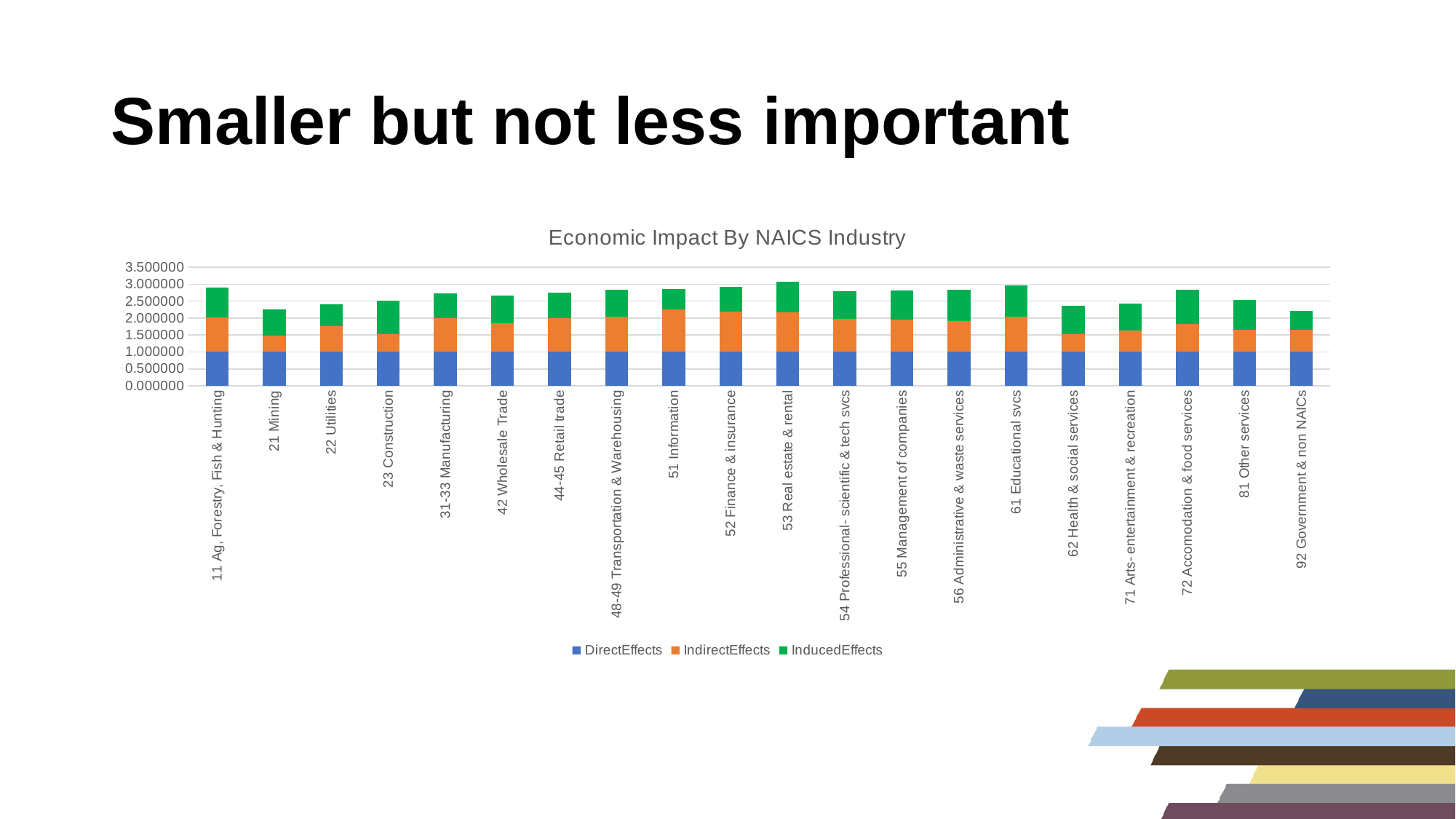
Which has the larger total stacked bar, 61 Educational svcs or 62 Health & social services? 61 Educational svcs Which series is shown in green in the legend? InducedEffects How many series does the legend list? 3 Is the total stacked value for 11 Ag, Forestry, Fish & Hunting greater or less than 2.500000? greater Is the total stacked value for 21 Mining greater or less than 2.500000? less What kind of chart is shown on the slide? Stacked bar chart How many industry categories are shown on the x axis? 20 Is the total stacked value for 62 Health & social services greater or less than 2.500000? less Which has the larger total stacked bar, 53 Real estate & rental or 23 Construction? 53 Real estate & rental What is the title of the chart? Economic Impact By NAICS Industry Which industry has the highest total stacked bar? 53 Real estate & rental